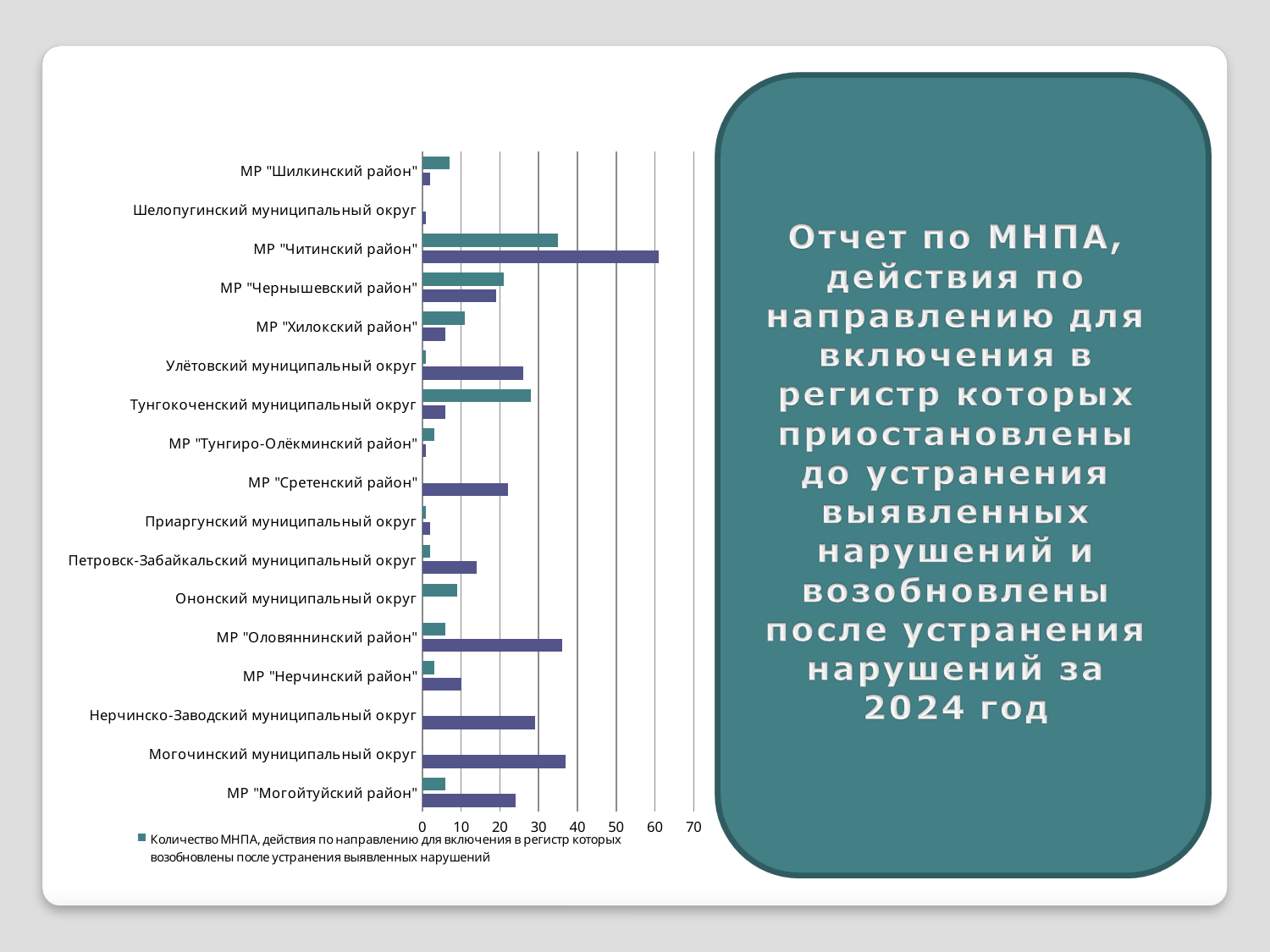
Is the purple bar for МР "Читинский район" greater or less than 50? greater Which category has the longest teal bar in the chart? МР "Читинский район" For МР "Оловяннинский район", which bar is longer: the teal bar or the purple bar? the purple bar How many municipal districts (categories) are listed on the vertical axis of the chart? 17 Is the purple bar for Улётовский муниципальный округ greater or less than 30? less Which category has the longest purple bar in the chart? МР "Читинский район" Which has the longer purple bar: МР "Читинский район" or Могочинский муниципальный округ? МР "Читинский район" What is the highest value shown on the horizontal axis of the chart? 70 What kind of chart is shown on the slide? bar chart Is the teal bar for Тунгокоченский муниципальный округ greater or less than 20? greater Which has the longer teal bar: Тунгокоченский муниципальный округ or МР "Хилокский район"? Тунгокоченский муниципальный округ